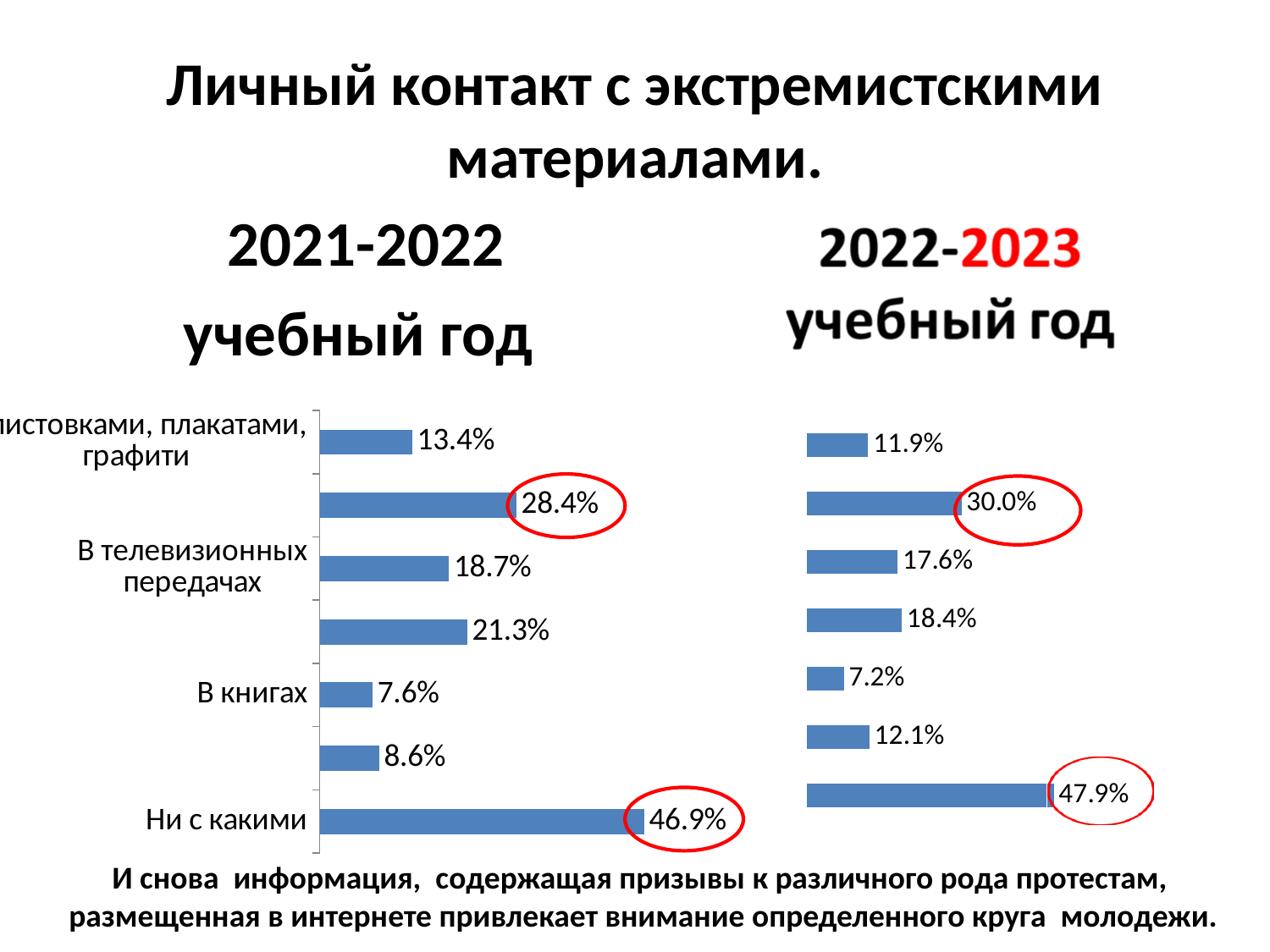
In the 2021-2022 учебный год chart, which is larger: 'В телевизионных передачах' or 'В книгах'? В телевизионных передачах In the 2021-2022 учебный год chart, which category has the highest value? Ни с какими In the 2022-2023 учебный год chart, what is the value of the smallest bar? 7.2% What kind of chart is used on the left (2021-2022 учебный год) side of the slide? bar chart What is the main title of the slide above the two charts? Личный контакт с экстремистскими материалами. In the 2021-2022 учебный год chart, which labeled category has the lowest value? В книгах In the 2021-2022 учебный год chart, what is the difference between 'Ни с какими' and 'В книгах'? 39.3% How many bars are plotted in the 2022-2023 учебный год chart? 7 In the 2021-2022 учебный год chart, what is the value for 'В телевизионных передачах'? 18.7% In the 2021-2022 учебный год chart, what is the value for 'В книгах'? 7.6% In the 2022-2023 учебный год chart, what is the value of the bottom (largest) bar? 47.9% In the 2021-2022 учебный год chart, what is the value for 'Ни с какими'? 46.9%